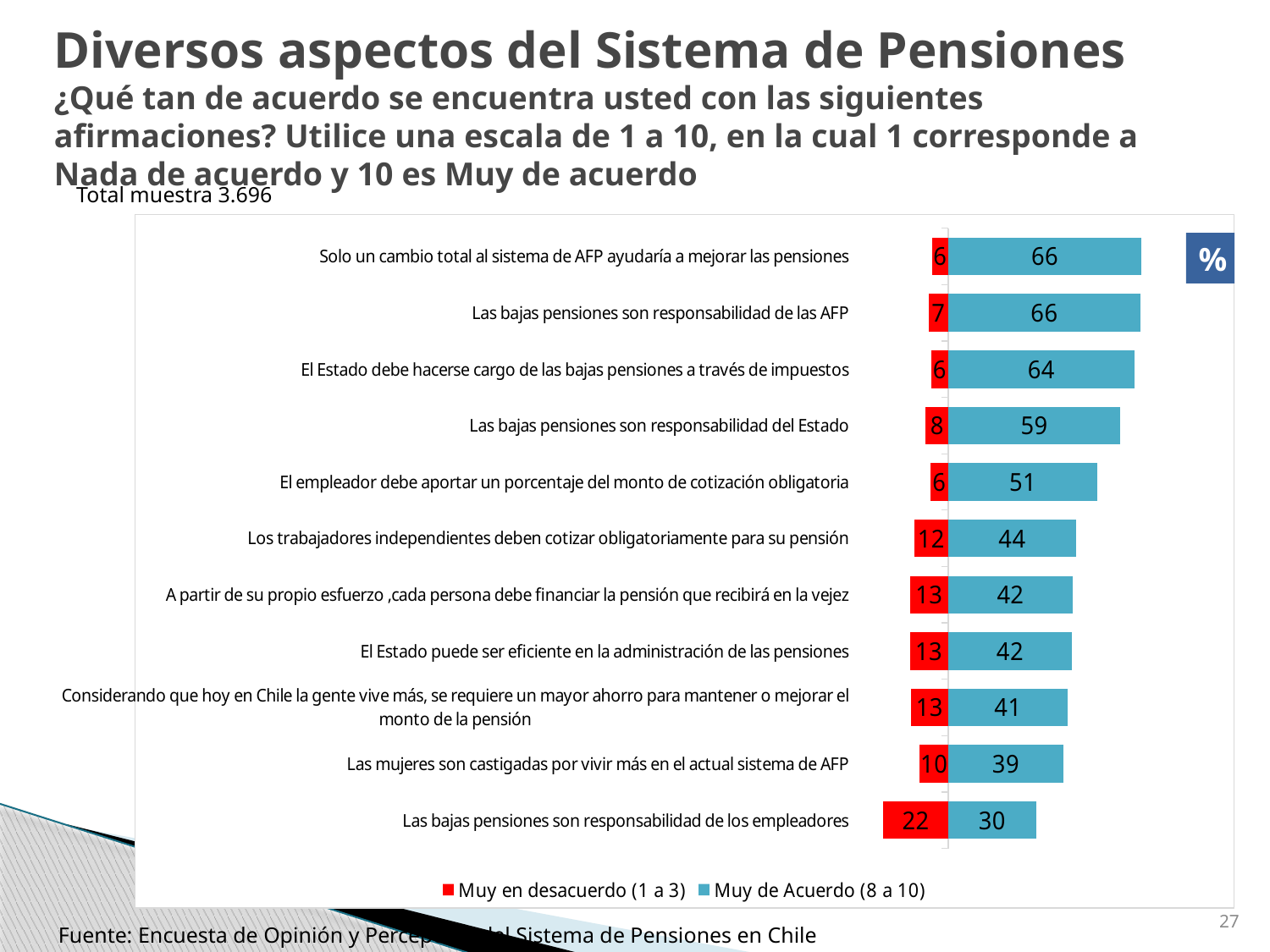
What is the 'Muy en desacuerdo (1 a 3)' value for 'Los trabajadores independientes deben cotizar obligatoriamente para su pensión'? 12 Which has a larger 'Muy de Acuerdo (8 a 10)' value: 'Los trabajadores independientes deben cotizar obligatoriamente para su pensión' or 'Las mujeres son castigadas por vivir más en el actual sistema de AFP'? Los trabajadores independientes deben cotizar obligatoriamente para su pensión How many series does the legend list? 2 Which statement has the lowest 'Muy de Acuerdo (8 a 10)' value? Las bajas pensiones son responsabilidad de los empleadores Which colour represents the 'Muy en desacuerdo (1 a 3)' series? red Which statement has the highest 'Muy en desacuerdo (1 a 3)' value? Las bajas pensiones son responsabilidad de los empleadores What is the 'Muy de Acuerdo (8 a 10)' value for 'Las bajas pensiones son responsabilidad del Estado'? 59 What is the 'Muy en desacuerdo (1 a 3)' value for 'Las bajas pensiones son responsabilidad de los empleadores'? 22 How many statements (categories) are plotted in the chart? 11 What is the difference between the 'Muy de Acuerdo (8 a 10)' values for 'El Estado debe hacerse cargo de las bajas pensiones a través de impuestos' and 'Las mujeres son castigadas por vivir más en el actual sistema de AFP'? 25 What is the 'Muy de Acuerdo (8 a 10)' value for 'El empleador debe aportar un porcentaje del monto de cotización obligatoria'? 51 What type of chart is shown on the slide? bar chart